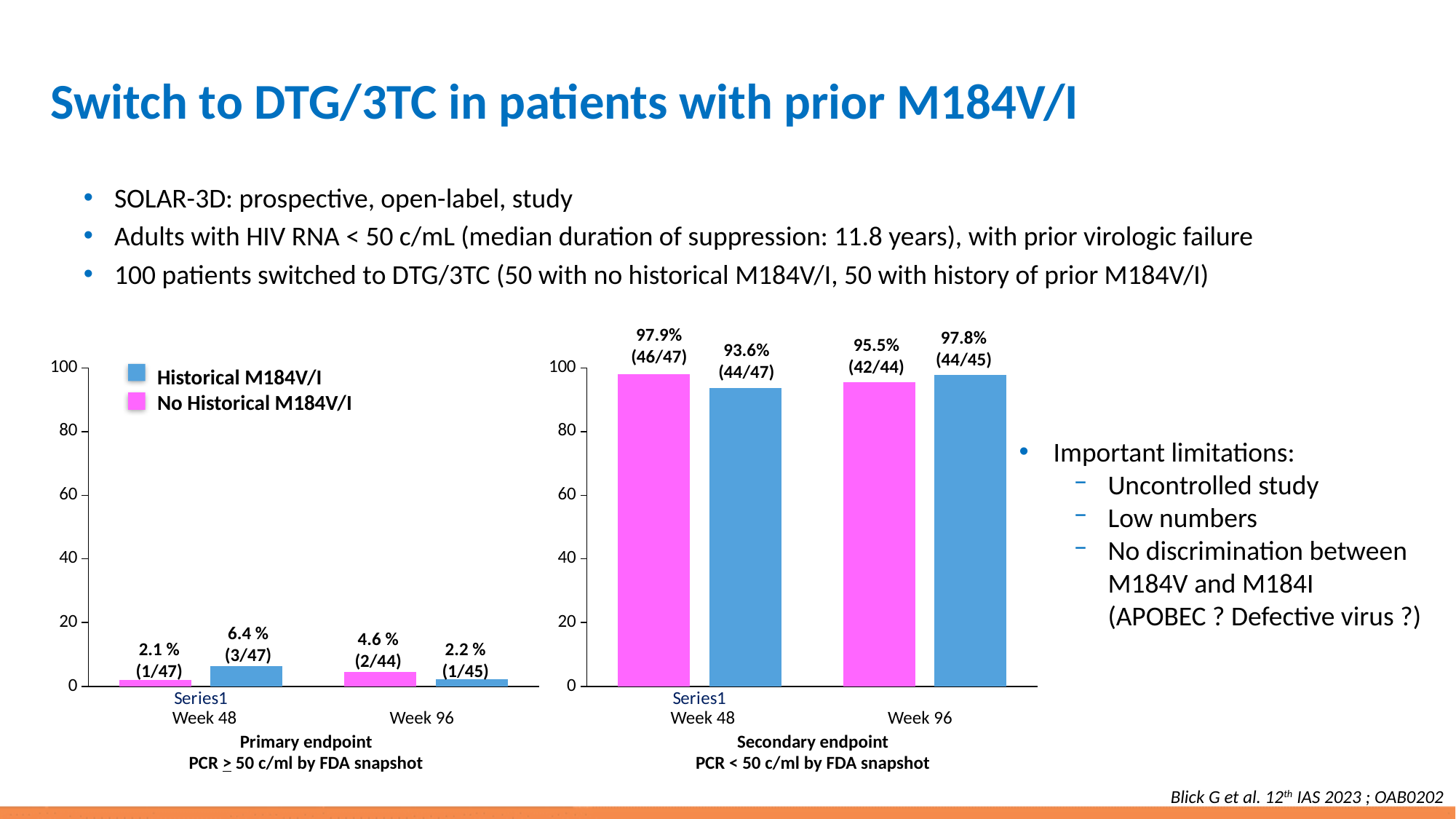
In the Secondary endpoint chart, what is the value for No Historical M184V/I at Week 48? 97.9% In the Primary endpoint chart, what is the value for Historical M184V/I at Week 48? 6.4 % In the Primary endpoint chart, which bar has the highest value? Historical M184V/I at Week 48 In the Secondary endpoint chart, which bar has the lowest value? Historical M184V/I at Week 48 In the Primary endpoint chart, which is larger at Week 96: Historical M184V/I or No Historical M184V/I? No Historical M184V/I What kind of chart is the Secondary endpoint chart? Bar chart How many series does the legend list? 2 In the Secondary endpoint chart, what is the difference between the No Historical M184V/I and Historical M184V/I values at Week 48? 4.3% In the Secondary endpoint chart, what is the value for Historical M184V/I at Week 96? 97.8% In the Primary endpoint chart, what is the value for No Historical M184V/I at Week 96? 4.6 % In the legend, which colour represents No Historical M184V/I? Pink In the Secondary endpoint chart, is the value for Historical M184V/I at Week 48 greater or less than 80? greater